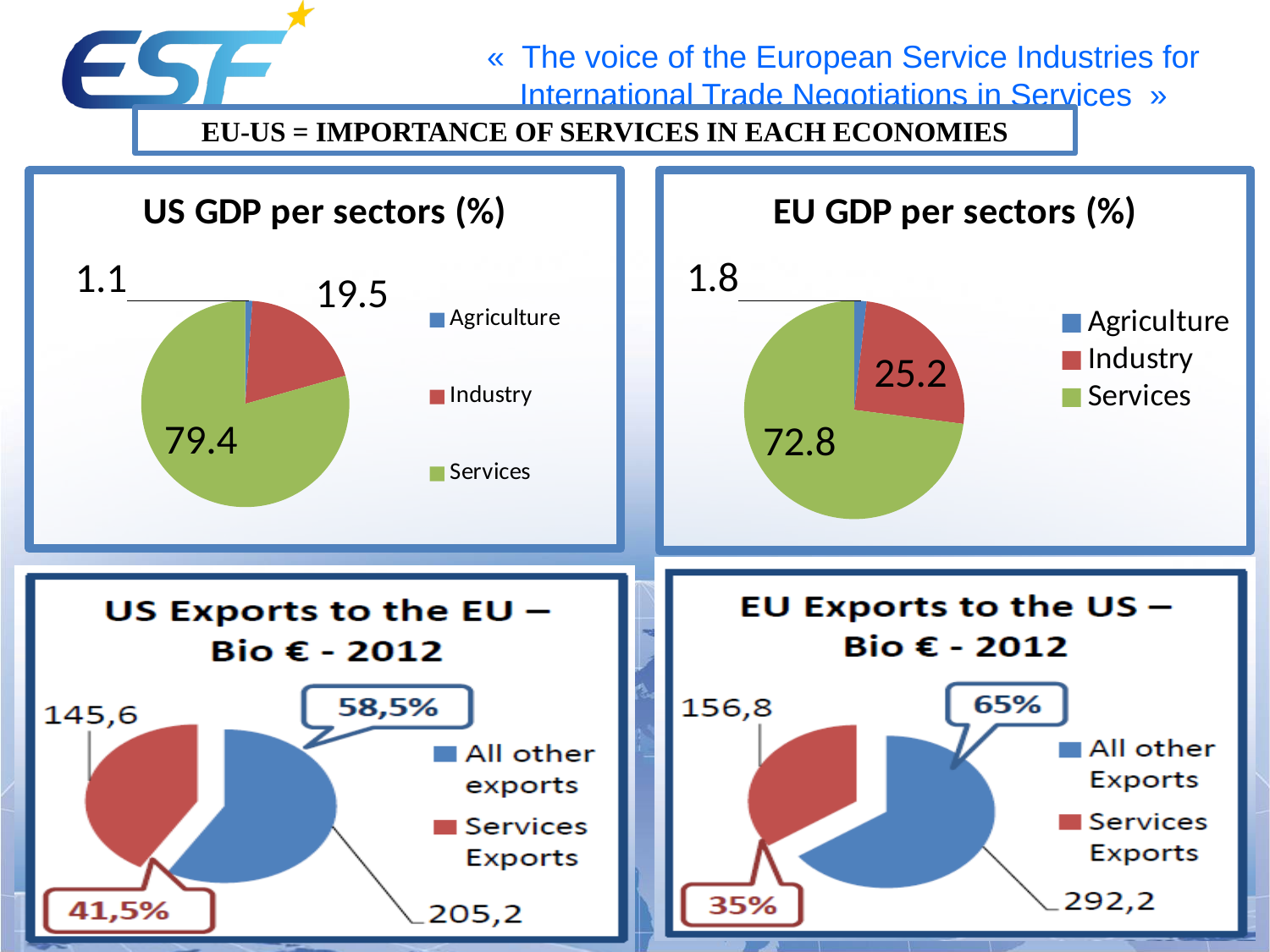
In the 'US GDP per sectors (%)' chart, what is the difference between the Services and Industry values? 59.9 In the 'US Exports to the EU – Bio € - 2012' chart, what percentage share do All other exports represent? 58,5% In the 'EU GDP per sectors (%)' chart, what is the value for Industry? 25.2 In the 'US GDP per sectors (%)' chart, what is the value for Services? 79.4 Is the Industry share larger in the 'US GDP per sectors (%)' chart or the 'EU GDP per sectors (%)' chart? EU GDP per sectors (%) In the 'US Exports to the EU – Bio € - 2012' chart, what is the value for Services Exports? 145,6 In the 'EU Exports to the US – Bio € - 2012' chart, what percentage share do Services Exports represent? 35% What type of chart is the 'US Exports to the EU – Bio € - 2012' chart? Pie chart In the 'EU GDP per sectors (%)' chart, which sector has the smallest share? Agriculture How many categories does the 'EU GDP per sectors (%)' chart show? 3 In the 'US GDP per sectors (%)' chart, which sector has the largest share? Services In the 'EU Exports to the US – Bio € - 2012' chart, what is the value for All other Exports? 292,2